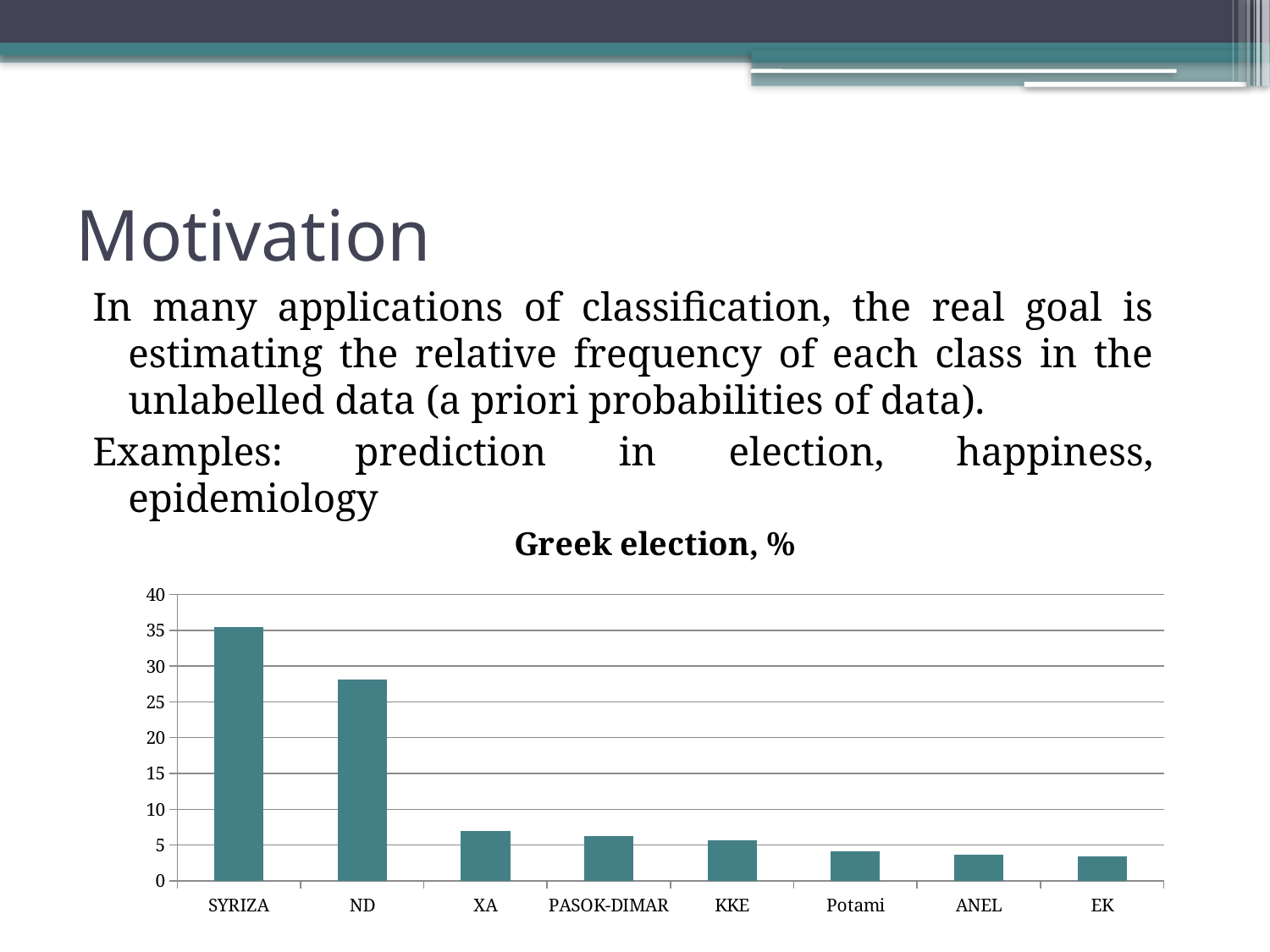
Is the value for ND greater or less than 25? greater Do the values rise or fall from left to right along the x axis? fall What kind of chart is shown on the slide? bar chart What is the title of the chart? Greek election, % Which is larger, the value for XA or the value for KKE? XA Which is larger, the value for SYRIZA or the value for ND? SYRIZA How many parties are shown on the x axis of the chart? 8 Is the value for ND greater or less than 30? less Which party has the highest value in the chart? SYRIZA Is the value for Potami greater or less than 5? less